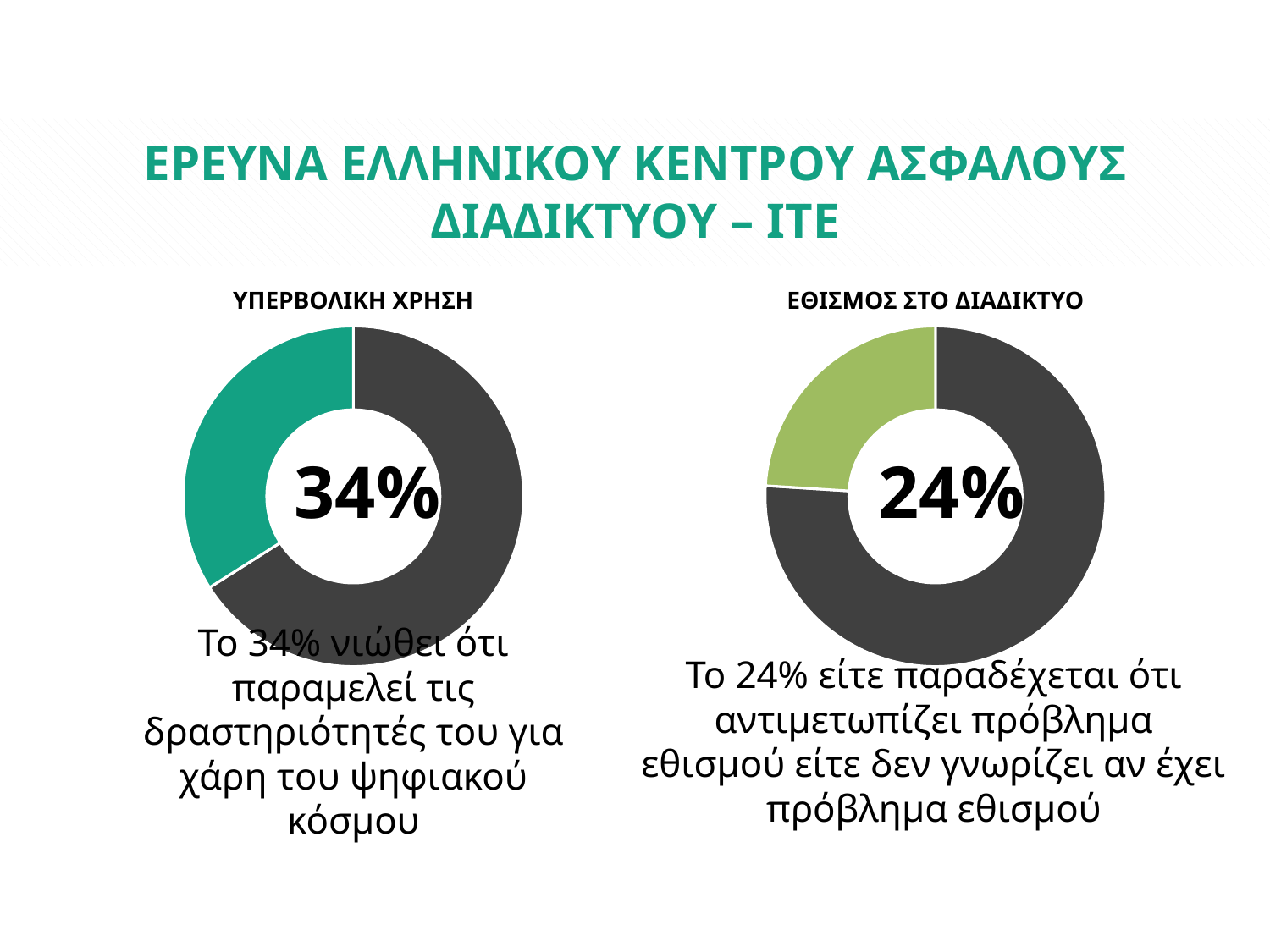
What kind of chart is used under the heading ΥΠΕΡΒΟΛΙΚΗ ΧΡΗΣΗ? Doughnut chart In the ΥΠΕΡΒΟΛΙΚΗ ΧΡΗΣΗ chart, what percentage is printed in the centre of the doughnut? 34% How many slices does the ΕΘΙΣΜΟΣ ΣΤΟ ΔΙΑΔΙΚΤΥΟ doughnut chart have? 2 Which chart shows the larger highlighted percentage, ΥΠΕΡΒΟΛΙΚΗ ΧΡΗΣΗ or ΕΘΙΣΜΟΣ ΣΤΟ ΔΙΑΔΙΚΤΥΟ? ΥΠΕΡΒΟΛΙΚΗ ΧΡΗΣΗ What colour is the highlighted slice in the ΕΘΙΣΜΟΣ ΣΤΟ ΔΙΑΔΙΚΤΥΟ chart? Light green What is the difference between the percentage shown in the ΥΠΕΡΒΟΛΙΚΗ ΧΡΗΣΗ chart and the percentage shown in the ΕΘΙΣΜΟΣ ΣΤΟ ΔΙΑΔΙΚΤΥΟ chart? 10% In the ΕΘΙΣΜΟΣ ΣΤΟ ΔΙΑΔΙΚΤΥΟ chart, what percentage is printed in the centre of the doughnut? 24% What is the title printed above the left-hand doughnut chart? ΥΠΕΡΒΟΛΙΚΗ ΧΡΗΣΗ In the ΕΘΙΣΜΟΣ ΣΤΟ ΔΙΑΔΙΚΤΥΟ chart, is the coloured (non-grey) slice more or less than half of the doughnut? less How many doughnut charts are shown on the slide? 2 In the ΥΠΕΡΒΟΛΙΚΗ ΧΡΗΣΗ chart, what share of the doughnut does the coloured (non-grey) slice represent? 34%